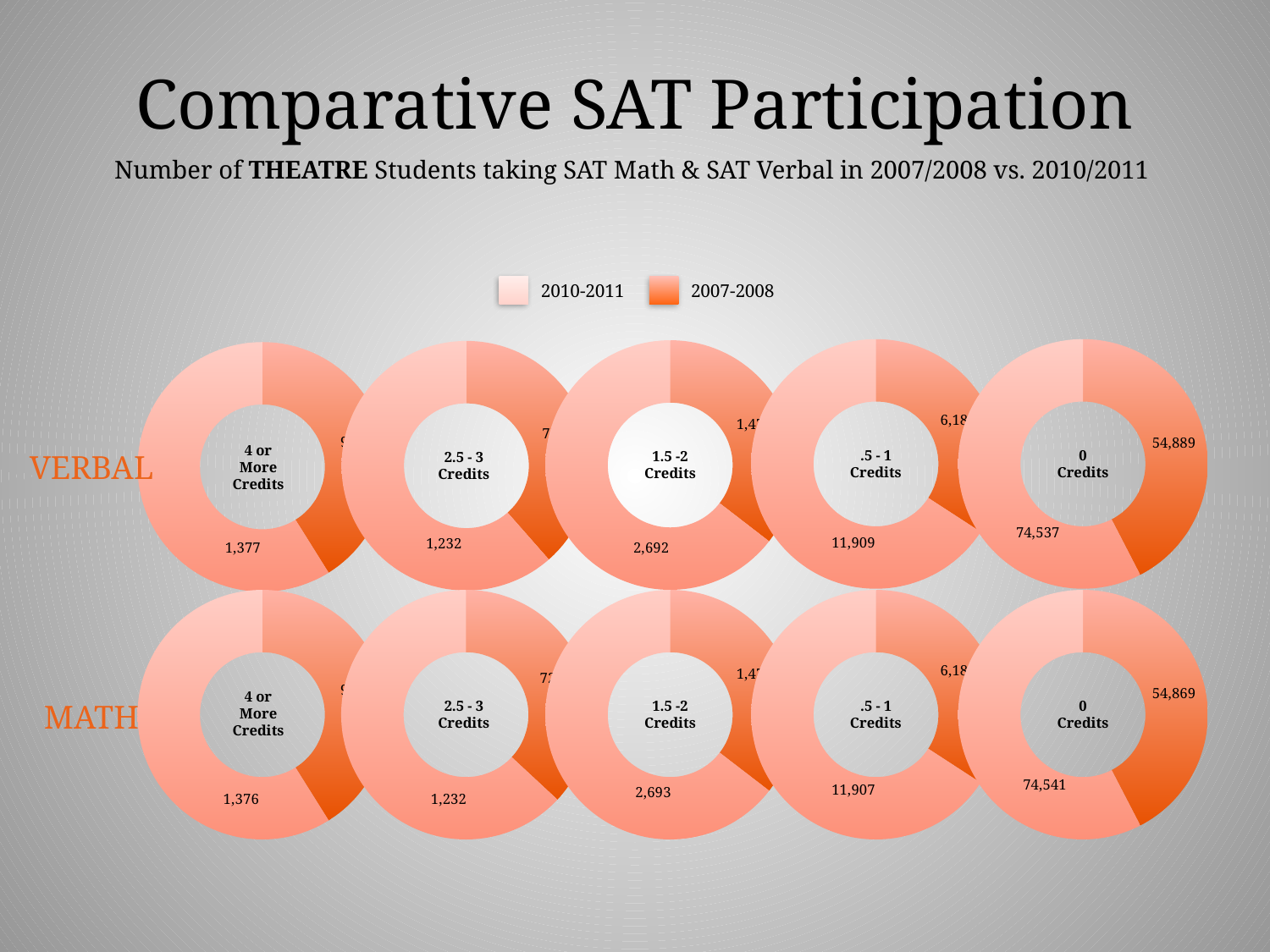
In the MATH row, what is the 2010-2011 value for the 1.5 - 2 Credits doughnut? 2,693 What kind of chart is used for each credit category on the slide? Doughnut chart In the VERBAL row, what is the 2010-2011 value for the 0 Credits doughnut? 74,537 How many doughnut charts are shown in the MATH row? 5 In the VERBAL 0 Credits doughnut, what is the difference between the 2010-2011 value and the 2007-2008 value? 19,648 In the VERBAL row, what is the 2010-2011 value for the 4 or More Credits doughnut? 1,377 In the MATH row, what is the 2010-2011 value for the 0 Credits doughnut? 74,541 In the VERBAL row, what is the 2007-2008 value for the 0 Credits doughnut? 54,889 In the MATH 0 Credits doughnut, which series has the larger value, 2010-2011 or 2007-2008? 2010-2011 How many series does the legend list? 2 In the VERBAL row, what is the 2010-2011 value for the .5 - 1 Credits doughnut? 11,909 In the MATH row, what is the 2007-2008 value for the 0 Credits doughnut? 54,869